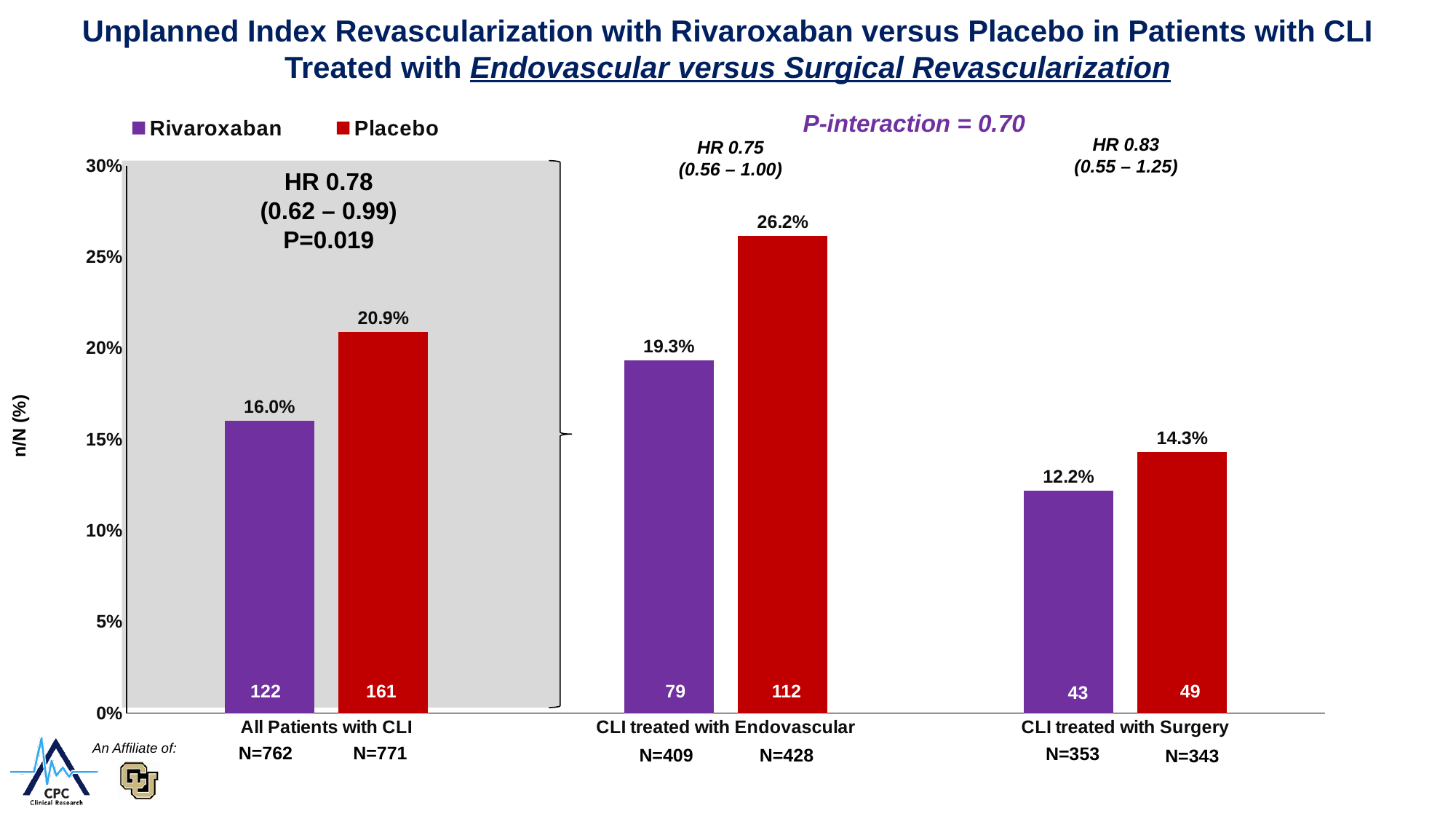
Which is larger in the All Patients with CLI group, the Rivaroxaban value or the Placebo value? Placebo Which category has the highest Placebo value? CLI treated with Endovascular How many series does the legend list? 2 Which category has the lowest Rivaroxaban value? CLI treated with Surgery What is the value for Rivaroxaban in the All Patients with CLI group? 16.0% What is the value for Placebo in the CLI treated with Surgery group? 14.3% What is the difference between the Placebo and Rivaroxaban values in the CLI treated with Endovascular group? 6.9% What is the value for Placebo in the CLI treated with Endovascular group? 26.2% Is the Rivaroxaban value for CLI treated with Surgery greater or less than 15%? less What kind of chart is shown on the slide? Bar chart How many categories are shown on the x axis? 3 What is the P-interaction value shown on the chart? 0.70